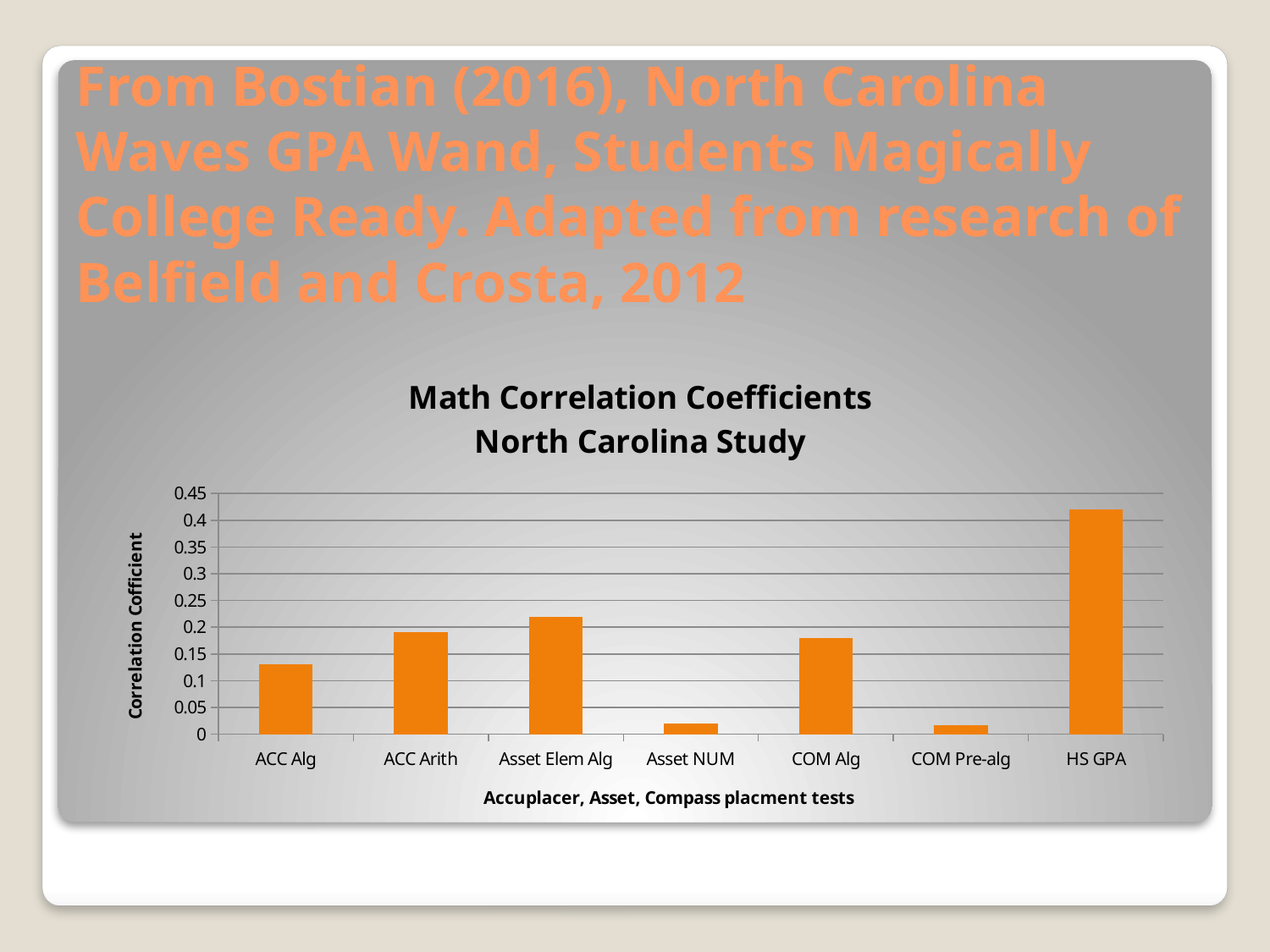
How many placement tests or categories are shown on the x axis of the chart? 7 Is the value for Asset Elem Alg greater or less than 0.2? greater Is the value for HS GPA greater or less than 0.4? greater Is the value for Asset NUM greater or less than 0.05? less Which is larger, the value for HS GPA or the value for Asset Elem Alg? HS GPA What is the title of the chart? Math Correlation Coefficients North Carolina Study Which is larger, the value for Asset Elem Alg or the value for ACC Alg? Asset Elem Alg Which category has the highest correlation coefficient? HS GPA What kind of chart is shown on the slide? bar chart